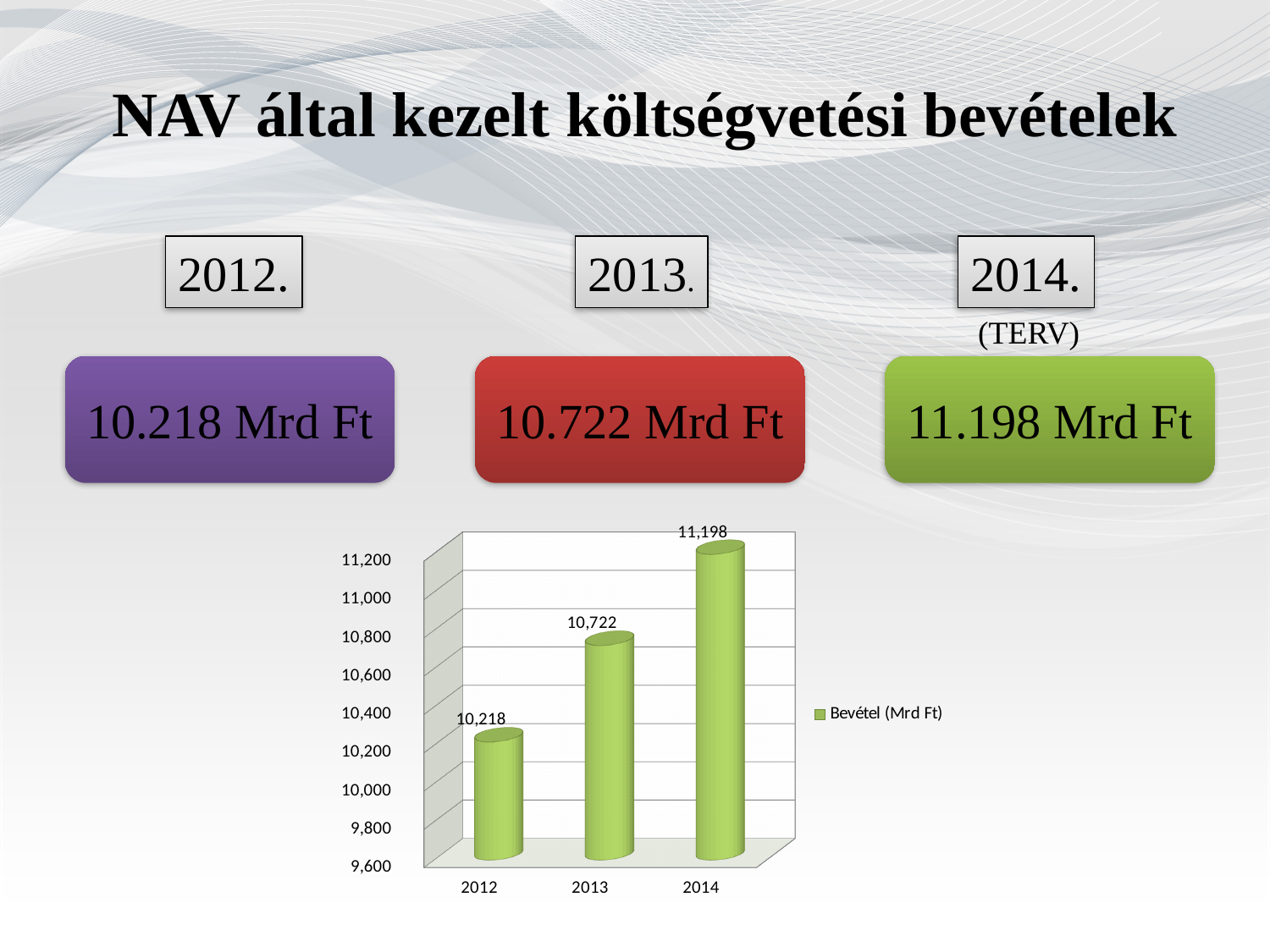
Which year has the lowest value in the chart? 2012 What is the value for 2012 in the chart? 10,218 What kind of chart is shown on the slide? bar chart What is the value for 2013 in the chart? 10,722 Which year has the highest value in the chart? 2014 What is the difference between the values for 2013 and 2012? 504 What is the value for 2014 in the chart? 11,198 How many series does the chart legend list? 1 Do the values rise or fall from 2012 to 2014? rise What is the difference between the values for 2014 and 2013? 476 How many years are shown on the x axis of the chart? 3 Which is larger, the value for 2012 or the value for 2014? 2014